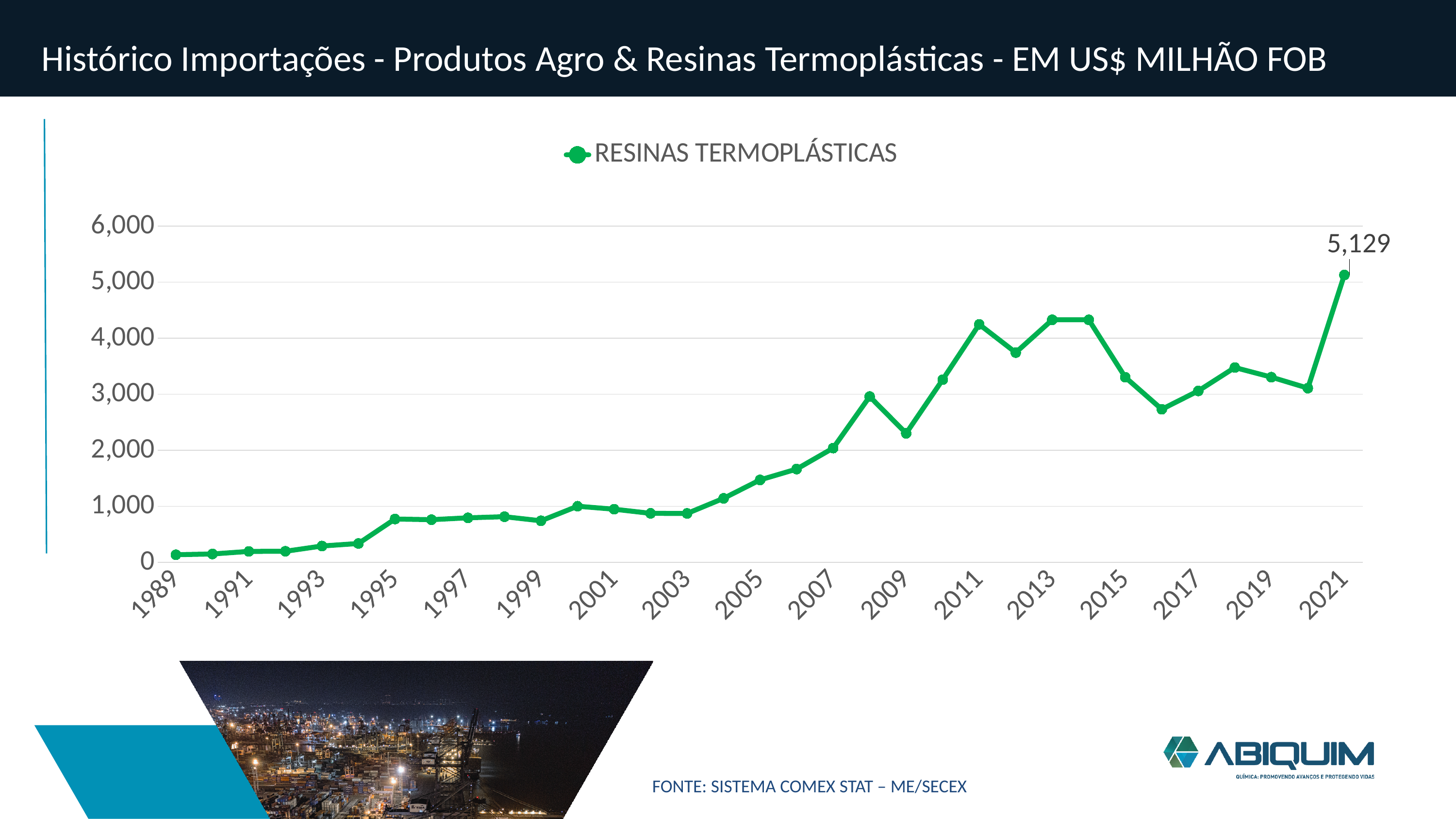
What is the name of the series shown in the legend? RESINAS TERMOPLÁSTICAS What is the value for 2021 in the RESINAS TERMOPLÁSTICAS series? 5,129 Overall, do the values rise or fall from 1989 to 2021? rise Is the value for 2011 greater or less than 4,000? greater Which year has the highest value for RESINAS TERMOPLÁSTICAS? 2021 Is the value for 2009 greater or less than 3,000? less How many data points are plotted on the line from 1989 to 2021? 33 How many series does the legend list? 1 Is the value for 2016 greater or less than 3,000? less Which year has the larger value, 2011 or 2012? 2011 What kind of chart is shown on the slide? line chart